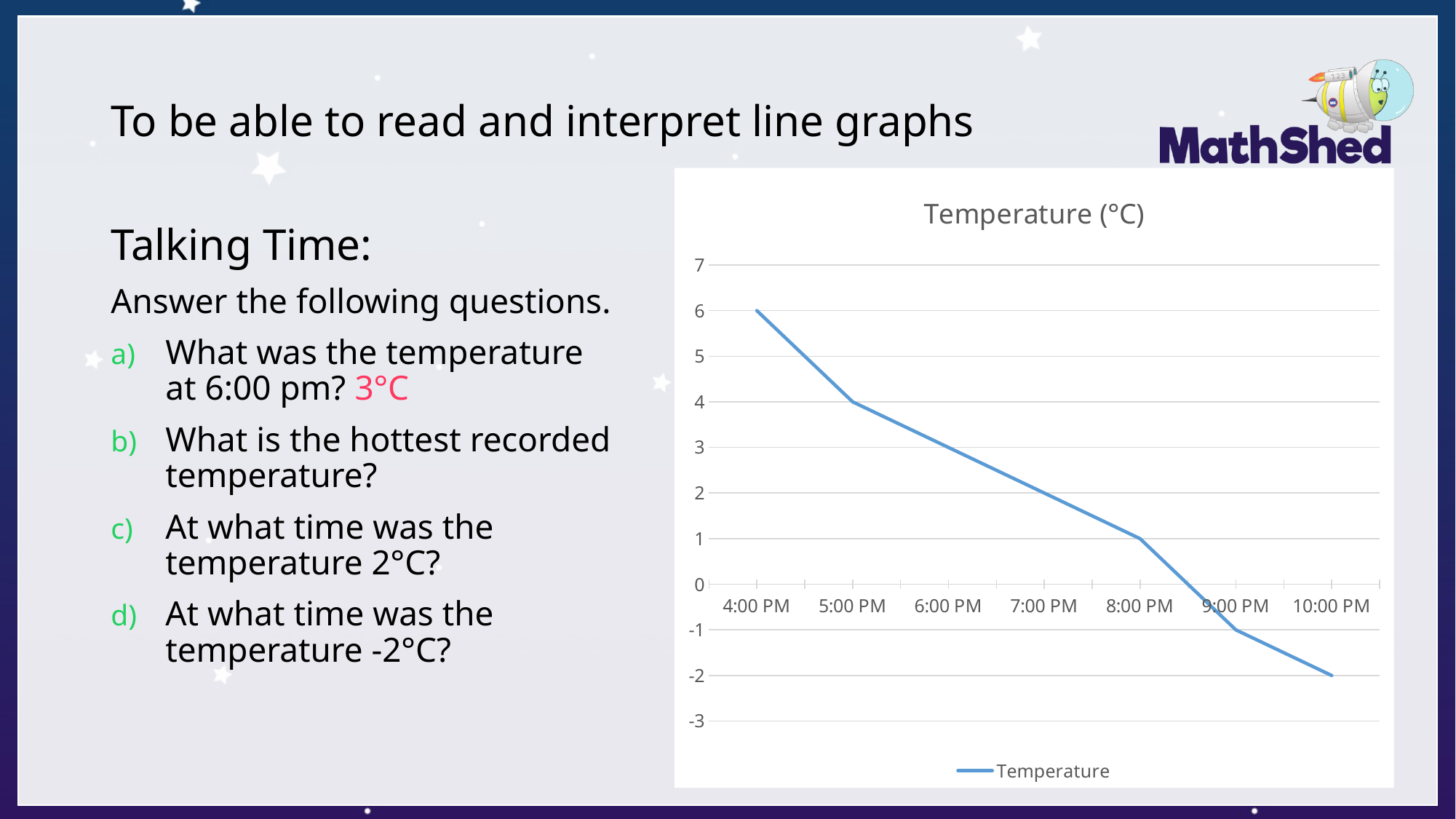
Does the temperature rise or fall from 4:00 PM to 10:00 PM? fall At which time was the temperature highest? 4:00 PM What was the temperature at 4:00 PM? 6 What was the temperature at 6:00 PM? 3 At which time was the temperature lowest? 10:00 PM What is the title of the chart? Temperature (°C) What was the temperature at 10:00 PM? -2 How many time points are plotted on the line? 7 What type of chart is shown on the slide? line chart How many series does the legend list? 1 What is the difference between the temperature at 4:00 PM and the temperature at 5:00 PM? 2 Which is higher, the temperature at 7:00 PM or at 9:00 PM? 7:00 PM